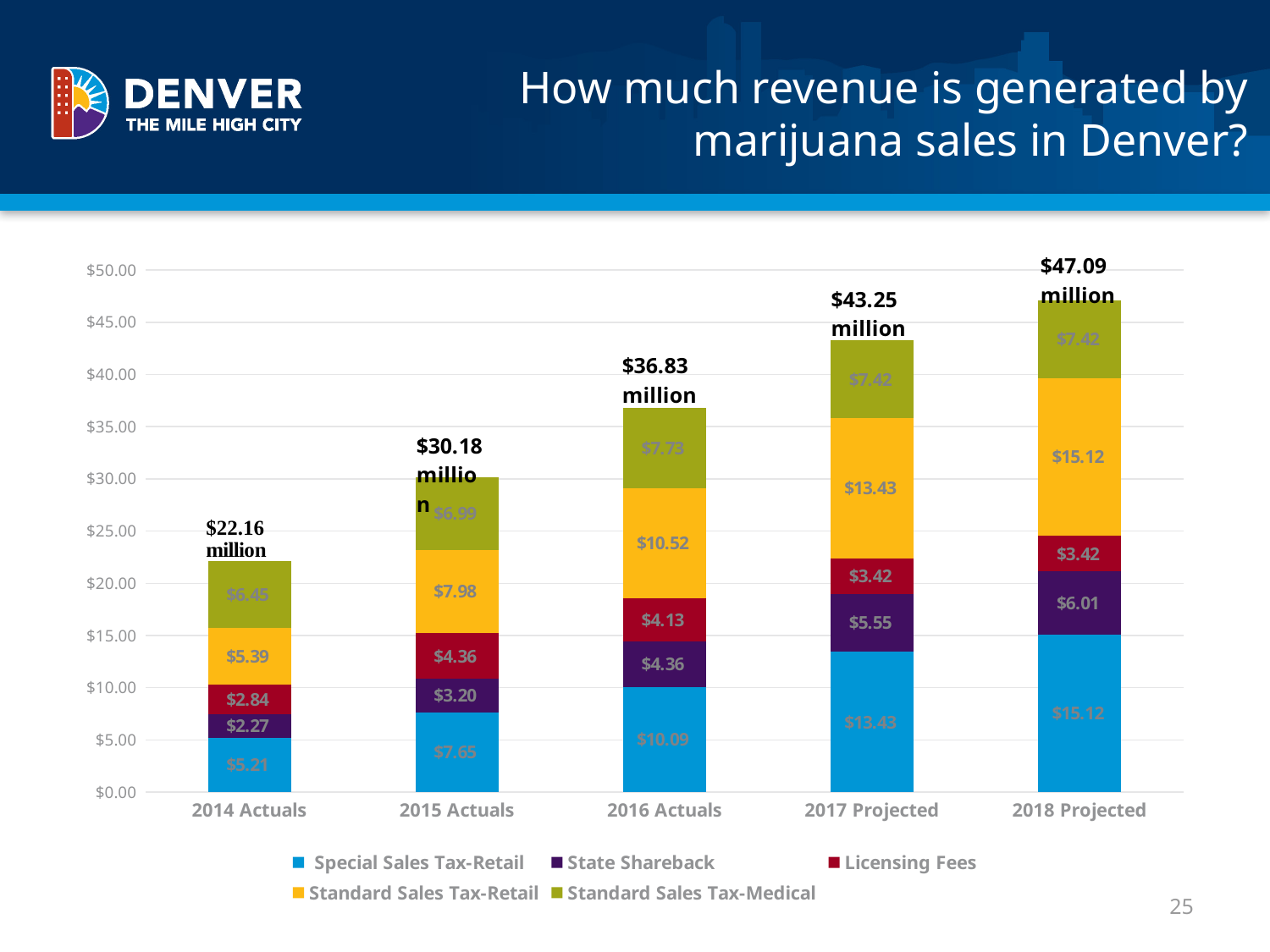
What is the total revenue shown for 2017 Projected? $43.25 million What is the value for Standard Sales Tax-Retail in 2016 Actuals? $10.52 How many series does the legend list? 5 Do the total revenues rise or fall from 2014 Actuals to 2018 Projected? Rise What is the value for Licensing Fees in 2015 Actuals? $4.36 What is the value for Special Sales Tax-Retail in 2018 Projected? $15.12 Which is larger in 2015 Actuals: Standard Sales Tax-Retail or Standard Sales Tax-Medical? Standard Sales Tax-Retail Which year has the lowest total revenue? 2014 Actuals What is the difference between Standard Sales Tax-Medical in 2016 Actuals and in 2017 Projected? $0.31 What is the value for State Shareback in 2014 Actuals? $2.27 Which year has the highest total revenue? 2018 Projected What is the total revenue shown for 2014 Actuals? $22.16 million